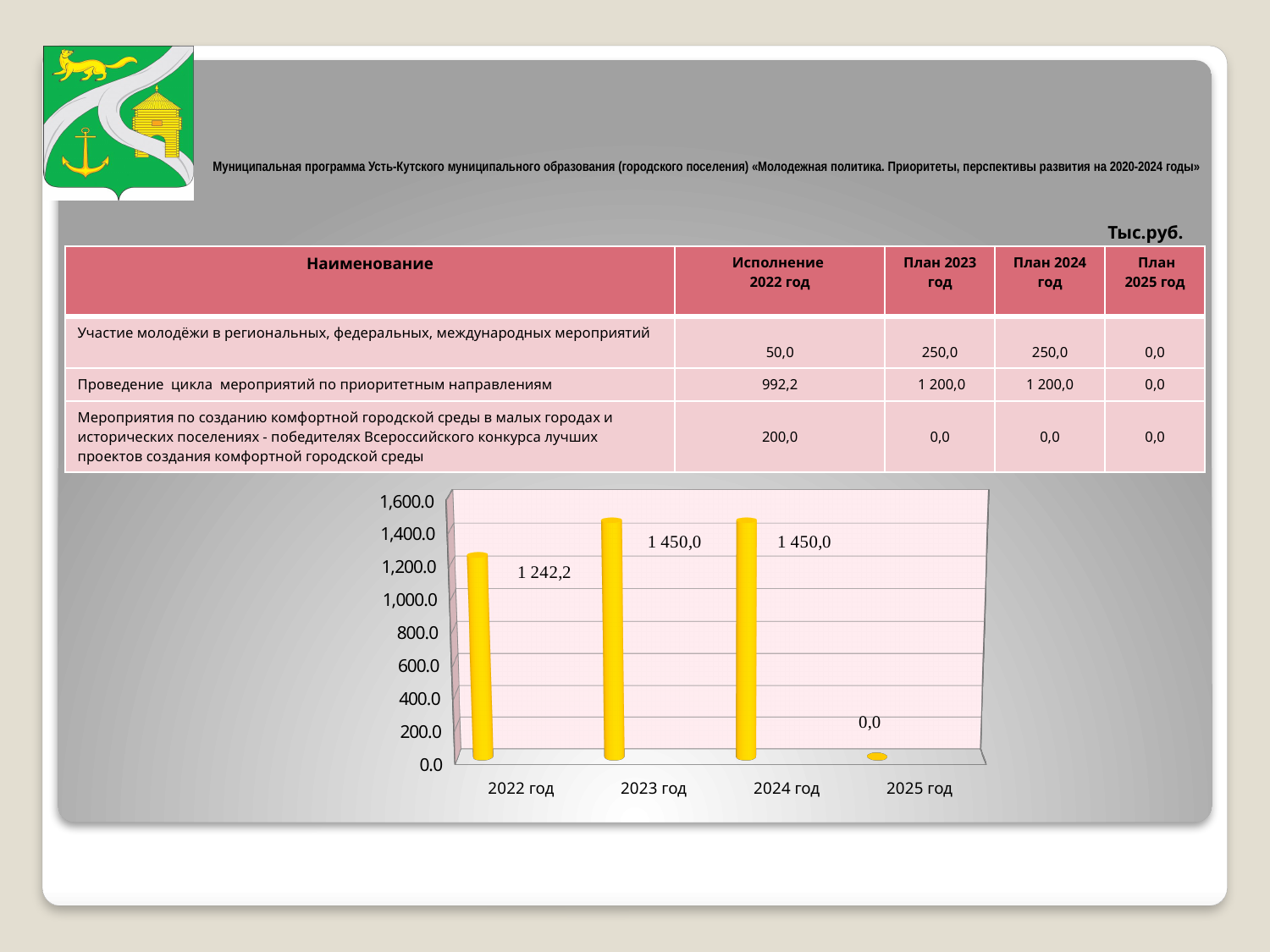
What colour are the bars in the chart? yellow What is the value for 2022 год in the chart? 1 242,2 What is the value for 2025 год in the chart? 0,0 Is the value for 2022 год greater or less than 1,000.0? greater Which is larger, the value for 2022 год or the value for 2023 год? 2023 год What is the value for 2023 год in the chart? 1 450,0 How many years are shown on the x axis of the chart? 4 What is the value for 2024 год in the chart? 1 450,0 What is the difference between the values for 2024 год and 2025 год? 1 450,0 What kind of chart is shown on the slide? bar chart Which year has the lowest value in the chart? 2025 год What is the difference between the values for 2023 год and 2022 год? 207,8